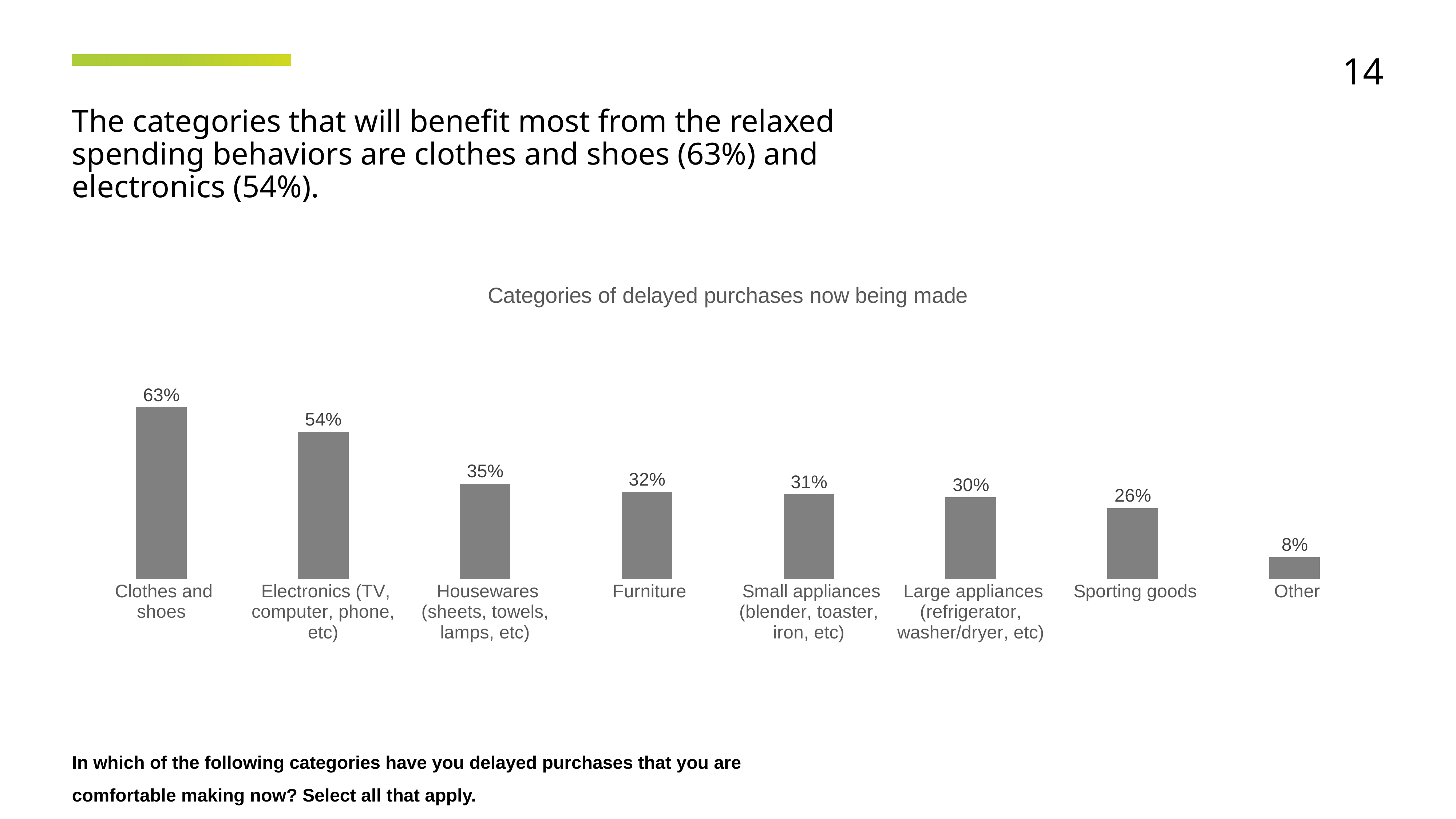
Which category has the highest value? Clothes and shoes What is the difference between the values for Housewares (sheets, towels, lamps, etc) and Other? 27% How many categories are shown in the chart? 8 Which is larger, the value for Electronics (TV, computer, phone, etc) or the value for Housewares (sheets, towels, lamps, etc)? Electronics (TV, computer, phone, etc) What is the value for Clothes and shoes? 63% Which category has the lowest value? Other What is the value for Large appliances (refrigerator, washer/dryer, etc)? 30% What is the value for Furniture? 32% What is the value for Sporting goods? 26% What kind of chart is shown on the slide? Bar chart What is the difference between the values for Clothes and shoes and Electronics (TV, computer, phone, etc)? 9% What is the title of the chart? Categories of delayed purchases now being made